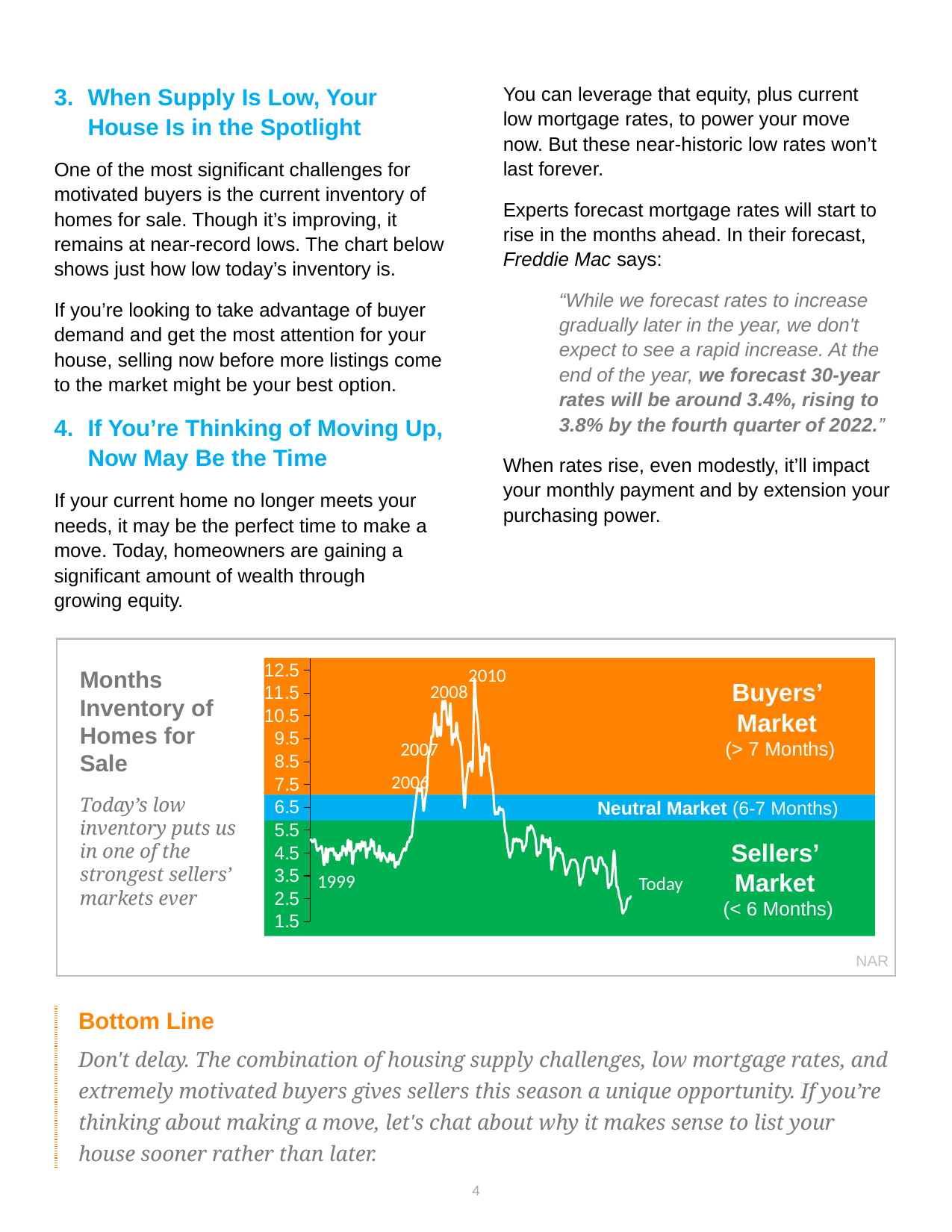
Does the months inventory rise or fall from 2006 to 2008? rise Which is higher, the months inventory around 2010 or around 1999? 2010 What kind of chart is shown on the slide? line chart Is the peak value around 2008 greater or less than 9.5? greater According to the chart, how many months of inventory define a Buyers' Market? > 7 Months Is the value for Today greater or less than 4.5? less What source is cited for the chart? NAR What is the title of the chart? Months Inventory of Homes for Sale Does the months inventory rise or fall from 2010 to Today? fall Which labeled year has the highest months inventory on the chart? 2010 Is the peak value around 2010 greater or less than 10.5? greater